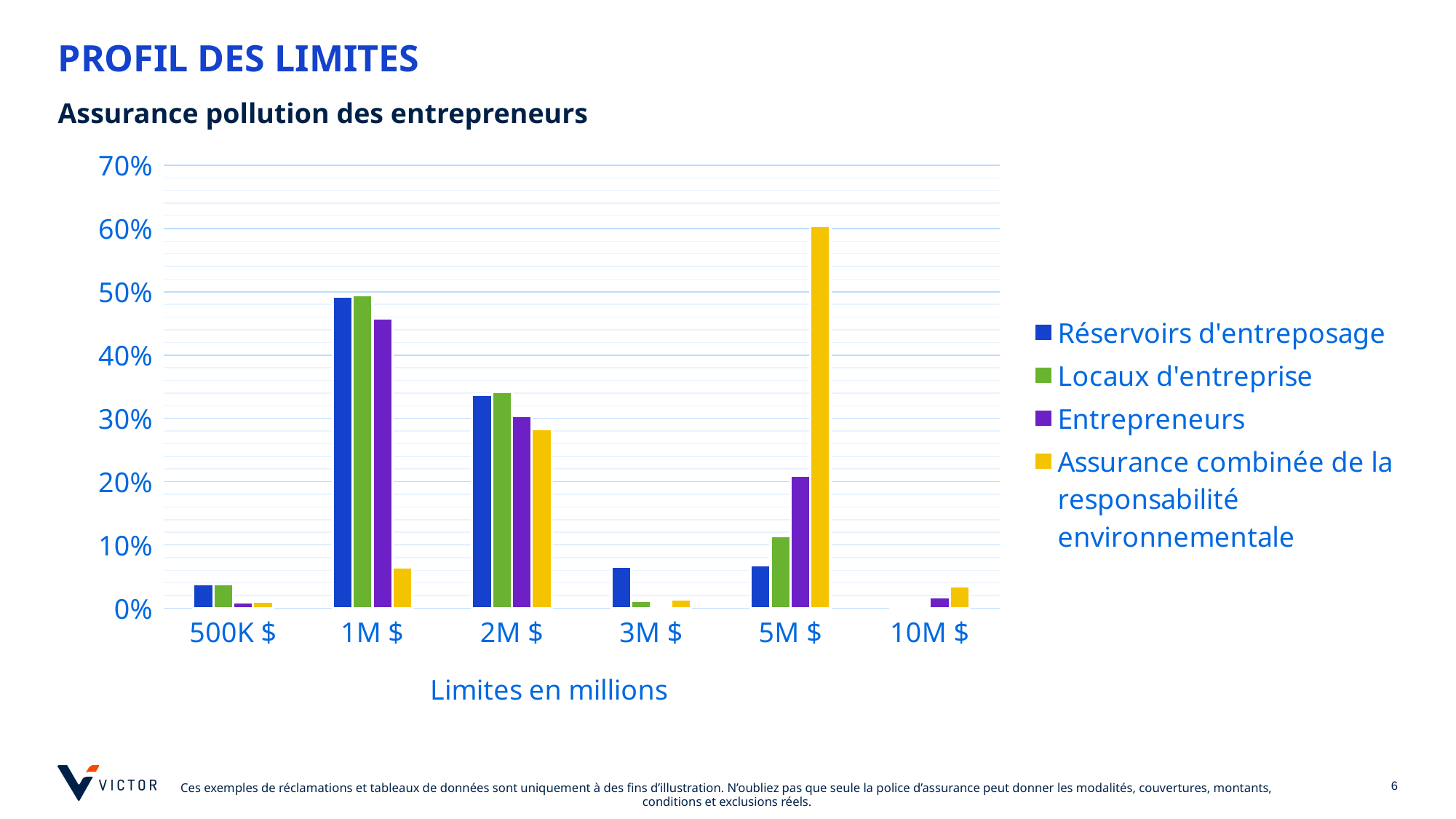
How many series does the legend list? 4 Which colour represents Assurance combinée de la responsabilité environnementale in the legend? Yellow Is the value for Réservoirs d'entreposage at 2M $ greater or less than 30%? greater At 2M $, which is larger: Réservoirs d'entreposage or Assurance combinée de la responsabilité environnementale? Réservoirs d'entreposage How many limit categories are shown on the x axis? 6 At which limit is the value for Assurance combinée de la responsabilité environnementale highest? 5M $ At which limit is the value for Entrepreneurs highest? 1M $ Is the value for Assurance combinée de la responsabilité environnementale at 5M $ greater or less than 50%? greater What is the title of the x axis? Limites en millions At 5M $, which is larger: Entrepreneurs or Locaux d'entreprise? Entrepreneurs What kind of chart is shown on the slide? Bar chart Is the value for Entrepreneurs at 1M $ greater or less than 40%? greater